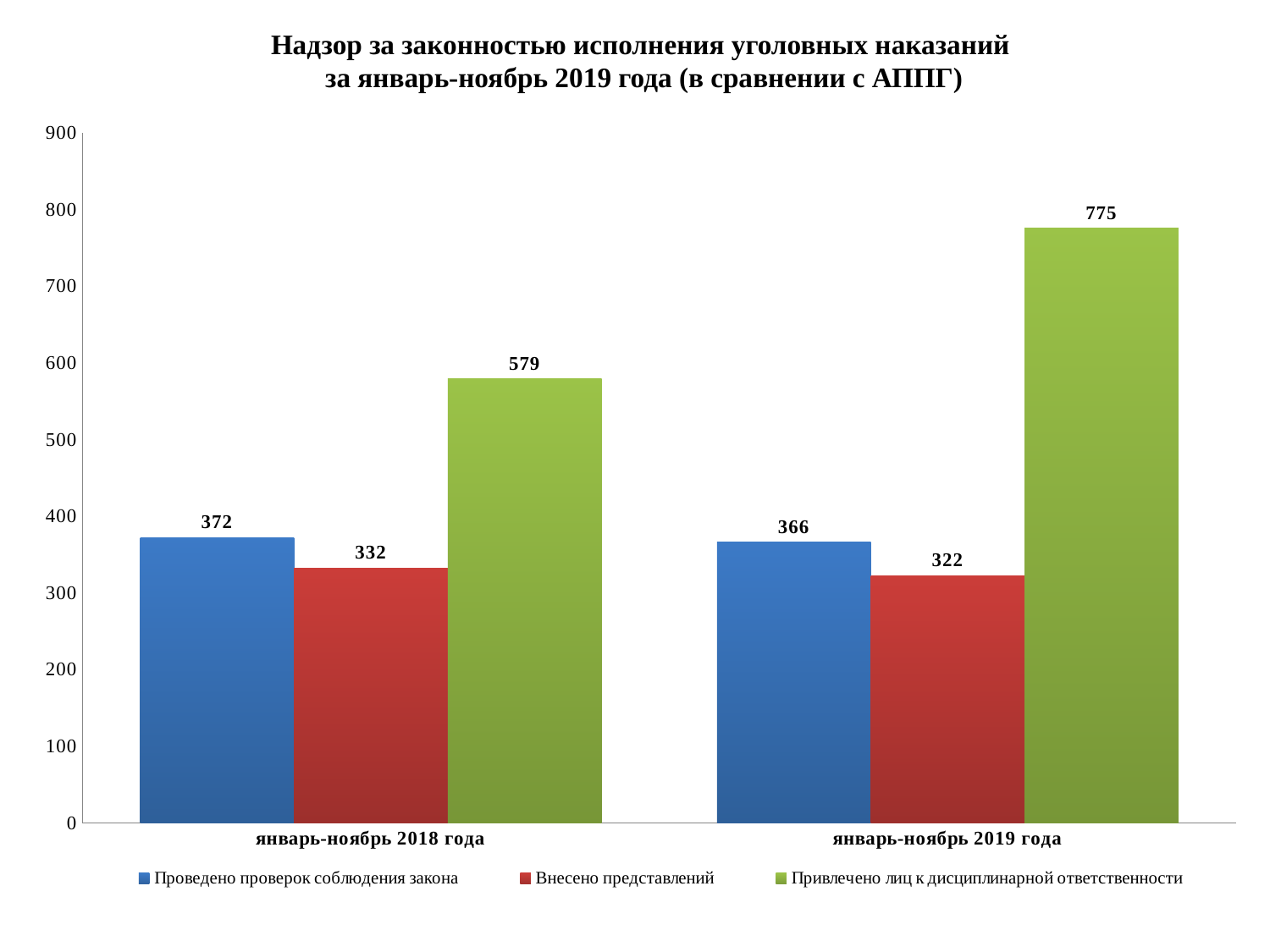
Which series has the lowest value in январь-ноябрь 2019 года? Внесено представлений Which series has the highest value in январь-ноябрь 2018 года? Привлечено лиц к дисциплинарной ответственности What is the difference between "Проведено проверок соблюдения закона" and "Внесено представлений" in январь-ноябрь 2018 года? 40 What colour represents "Внесено представлений" in the chart? Red How many series does the legend list? 3 Which is larger: "Проведено проверок соблюдения закона" in январь-ноябрь 2018 года or in январь-ноябрь 2019 года? январь-ноябрь 2018 года What kind of chart is shown on the slide? Bar chart What is the value for "Привлечено лиц к дисциплинарной ответственности" in январь-ноябрь 2019 года? 775 What is the value for "Проведено проверок соблюдения закона" in январь-ноябрь 2018 года? 372 How many categories are shown on the x axis? 2 What is the difference between the values for "Привлечено лиц к дисциплинарной ответственности" in январь-ноябрь 2019 года and январь-ноябрь 2018 года? 196 What is the value for "Внесено представлений" in январь-ноябрь 2019 года? 322